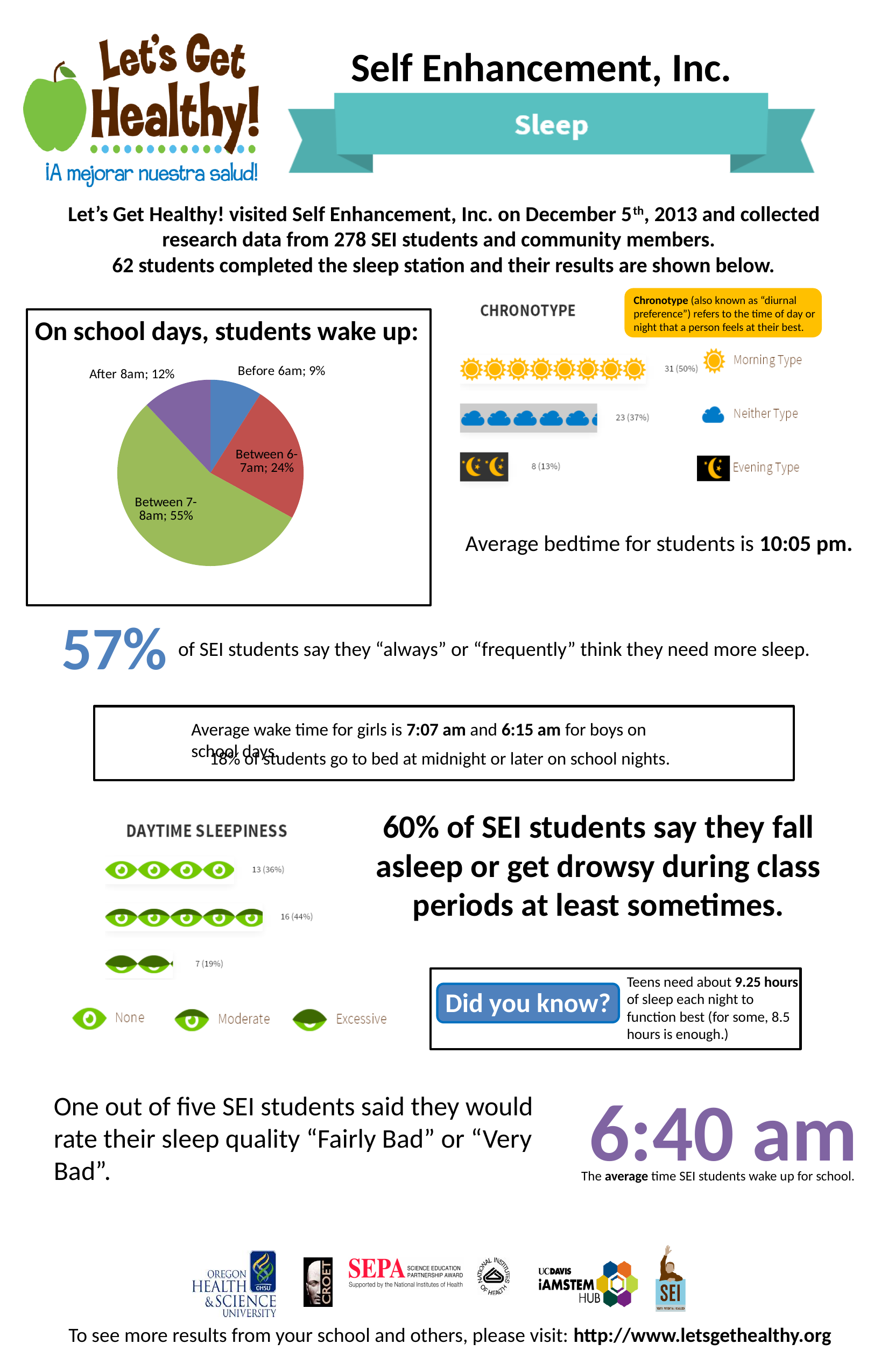
In the Daytime Sleepiness chart, which category has the most students? Moderate What type of chart is used to show when students wake up on school days? Pie chart How many slices does the pie chart 'On school days, students wake up:' have? 4 In the pie chart 'On school days, students wake up:', what share of students wake up after 8am? 12% In the pie chart 'On school days, students wake up:', what is the difference in percentage points between the 'Between 7-8am' and 'Between 6-7am' slices? 31 In the pie chart 'On school days, students wake up:', which wake-up time category has the smallest share? Before 6am In the pie chart 'On school days, students wake up:', what share of students wake up before 6am? 9% In the pie chart 'On school days, students wake up:', which wake-up time category has the largest share? Between 7-8am In the Chronotype chart, how many students are Morning Type? 31 (50%) In the pie chart 'On school days, students wake up:', which slice is larger: 'After 8am' or 'Between 6-7am'? Between 6-7am In the pie chart 'On school days, students wake up:', what share of students wake up between 7-8am? 55% In the Daytime Sleepiness chart, what is the value for the Excessive category? 7 (19%)